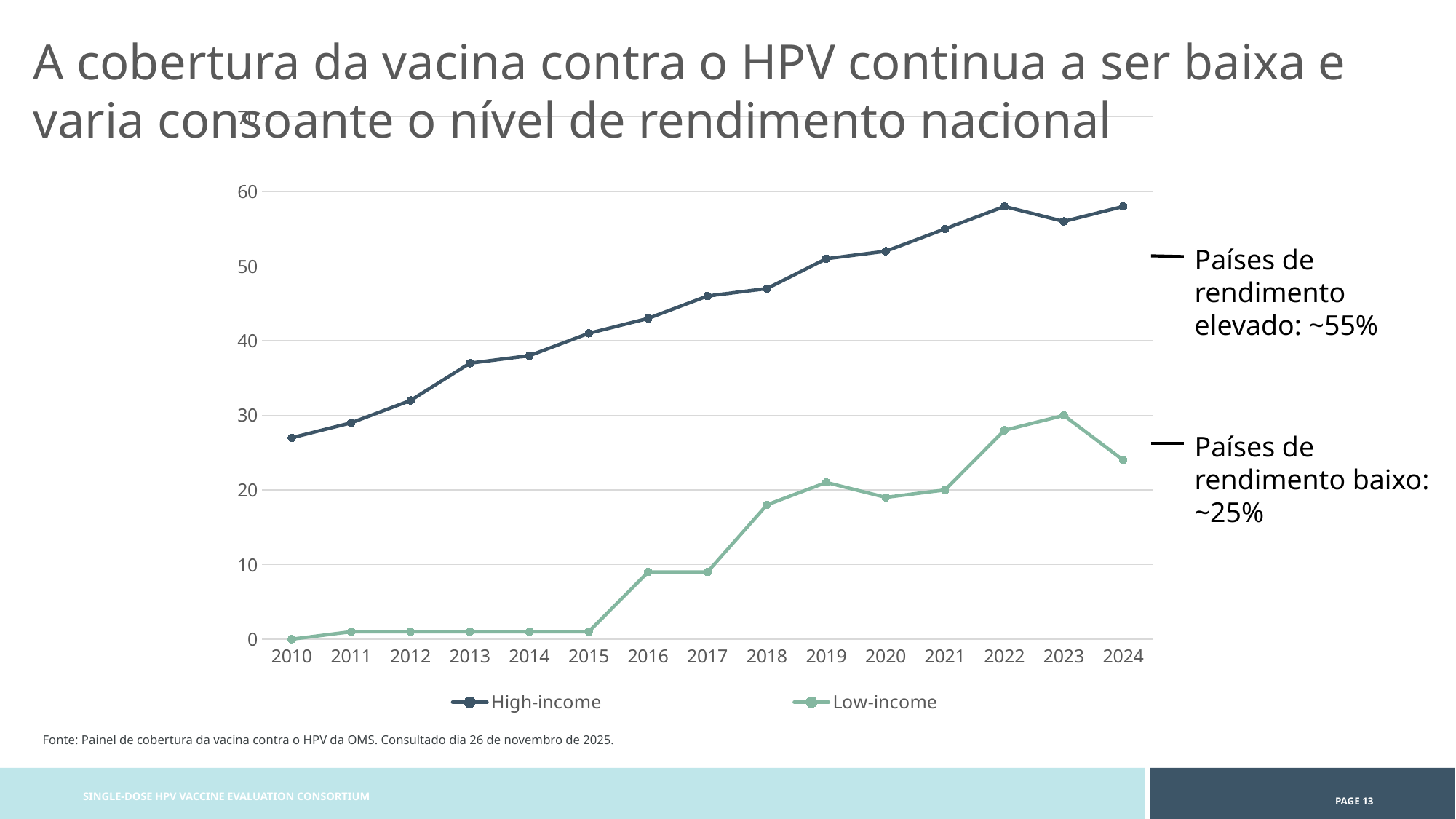
What is the Low-income value in 2010? 0 What are the two legend entries of the chart? High-income and Low-income Is the Low-income value for 2022 greater or less than 20? greater What kind of chart is shown on the slide? line chart Is the High-income value for 2010 greater or less than 30? less In which year is the Low-income series highest? 2023 In which year is the High-income series lowest? 2010 In 2024, which series has the larger value, High-income or Low-income? High-income How many series does the legend list? 2 Does the High-income series rise or fall from 2010 to 2024? rise How many years are shown along the x axis? 15 Is the High-income value for 2013 greater or less than 40? less